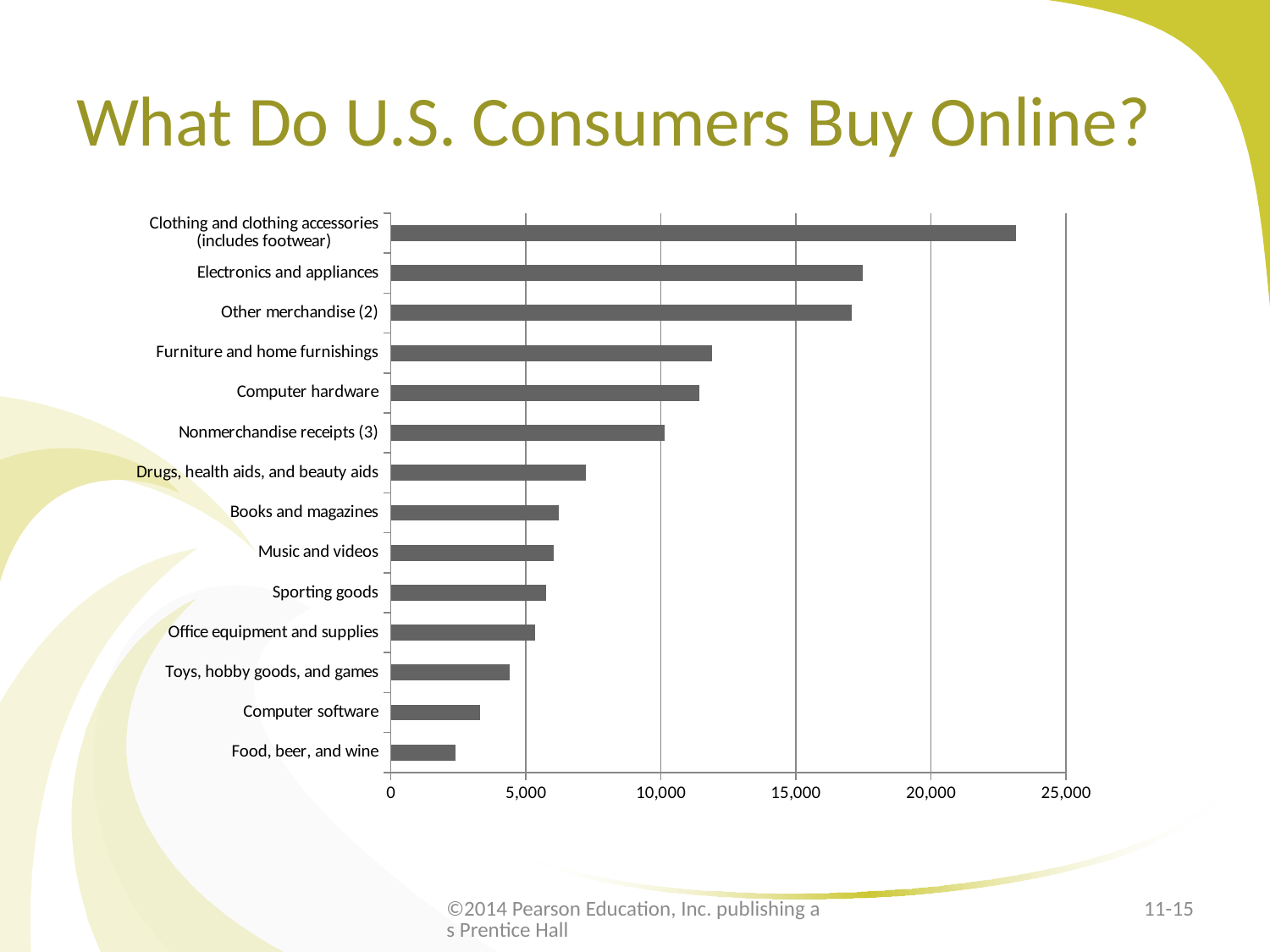
Is the value for Toys, hobby goods, and games greater or less than 5,000? less What kind of chart is shown on the slide? bar chart How many categories are shown in the chart? 14 Is the value for Clothing and clothing accessories (includes footwear) greater or less than 20,000? greater Is the value for Electronics and appliances greater or less than 15,000? greater What is the title of the slide containing the chart? What Do U.S. Consumers Buy Online? Which category has the highest value? Clothing and clothing accessories (includes footwear) Which category has the lowest value? Food, beer, and wine Which is larger, the value for Computer software or the value for Toys, hobby goods, and games? Toys, hobby goods, and games Which is larger, the value for Drugs, health aids, and beauty aids or the value for Books and magazines? Drugs, health aids, and beauty aids